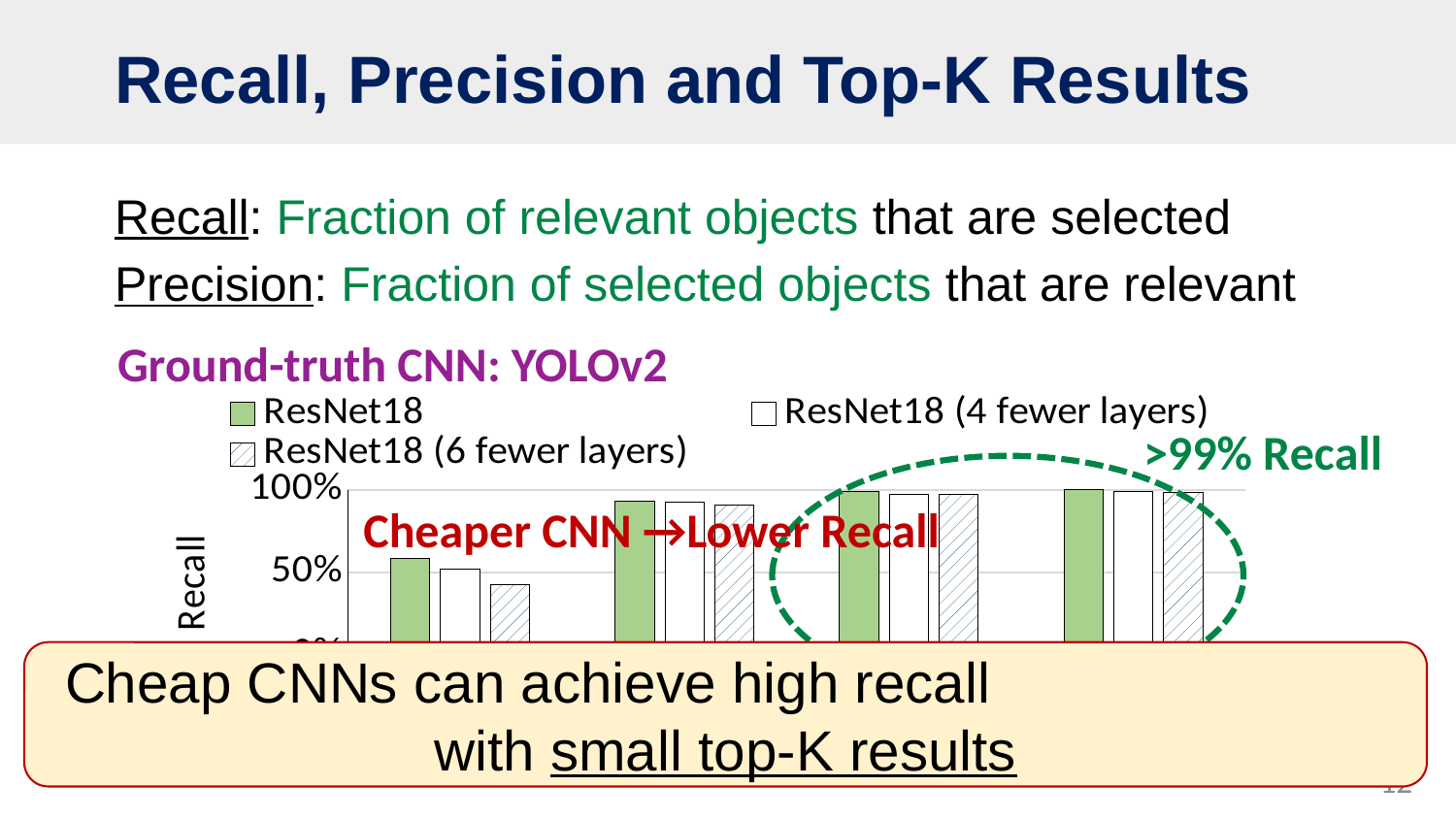
How many groups of bars are plotted in the chart? 4 In the leftmost group of bars, which is larger: the recall for ResNet18 or for ResNet18 (6 fewer layers)? ResNet18 In the second group of bars from the left, is the value for ResNet18 (4 fewer layers) greater or less than 50%? greater Which series in the legend is drawn with a hatched pattern? ResNet18 (6 fewer layers) In the leftmost group of bars, which series has the highest recall? ResNet18 In the leftmost group of bars, is the value for ResNet18 (6 fewer layers) greater or less than 50%? less Do the recall values for ResNet18 rise or fall moving from left to right across the groups? rise In the leftmost group of bars, is the value for ResNet18 greater or less than 50%? greater In the leftmost group of bars, which series has the lowest recall? ResNet18 (6 fewer layers) What is the label on the chart's vertical axis? Recall What kind of chart is shown on the slide? bar chart How many series does the chart's legend list? 3